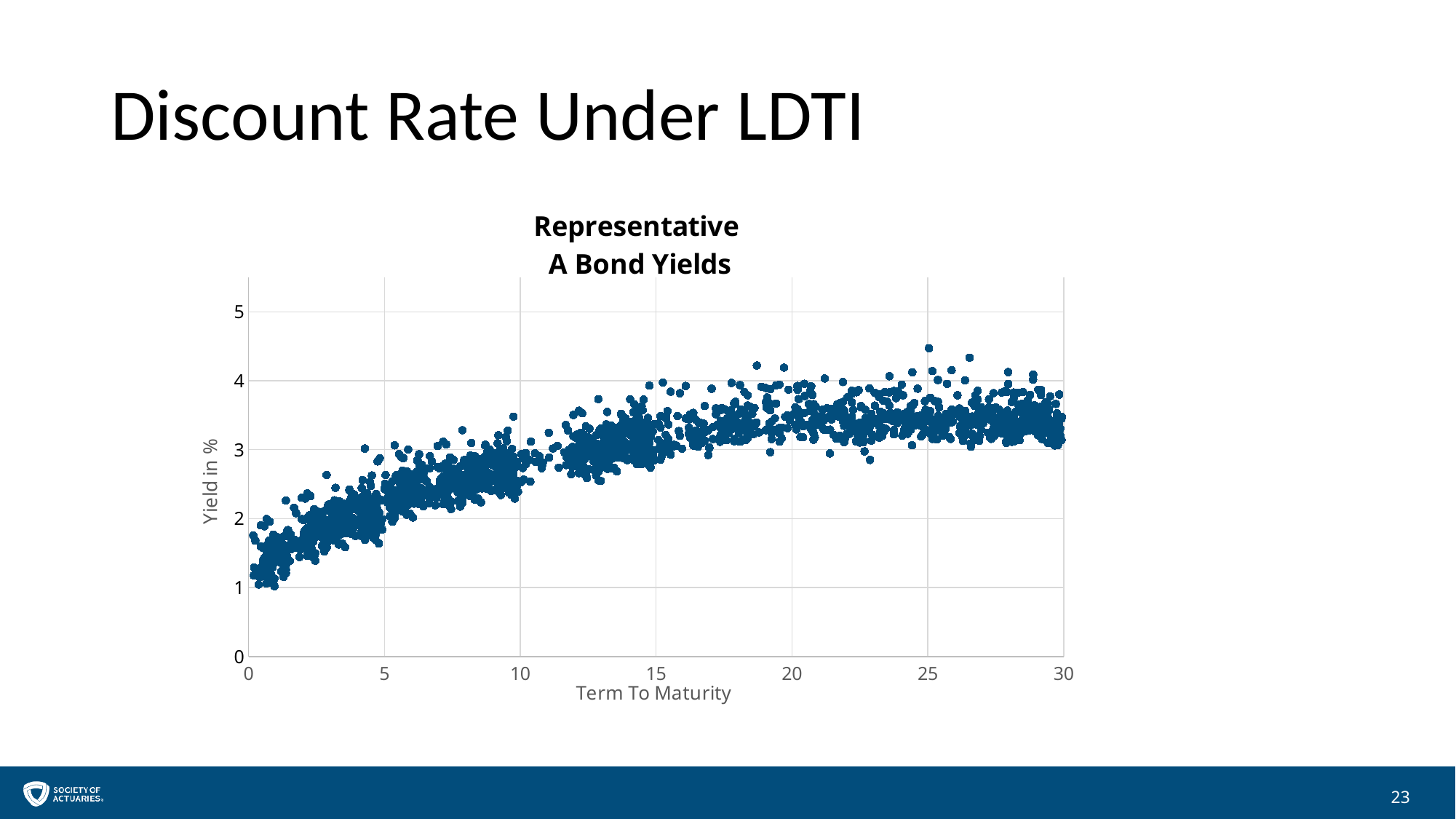
Are the yields for terms to maturity near 0 greater or less than 2%? less Do the yields generally rise or fall as term to maturity increases? rise What is the highest value shown on the y axis? 5 Are the yields for terms to maturity near 30 greater or less than 2%? greater Are the yields for terms to maturity near 25 greater or less than 1%? greater What is the label of the x axis? Term To Maturity What is the title of the chart? Representative A Bond Yields What is the largest term to maturity shown on the x axis? 30 Are yields at a term to maturity of 25 higher or lower than yields at a term to maturity of 1? higher What kind of chart is shown on the slide? scatter plot